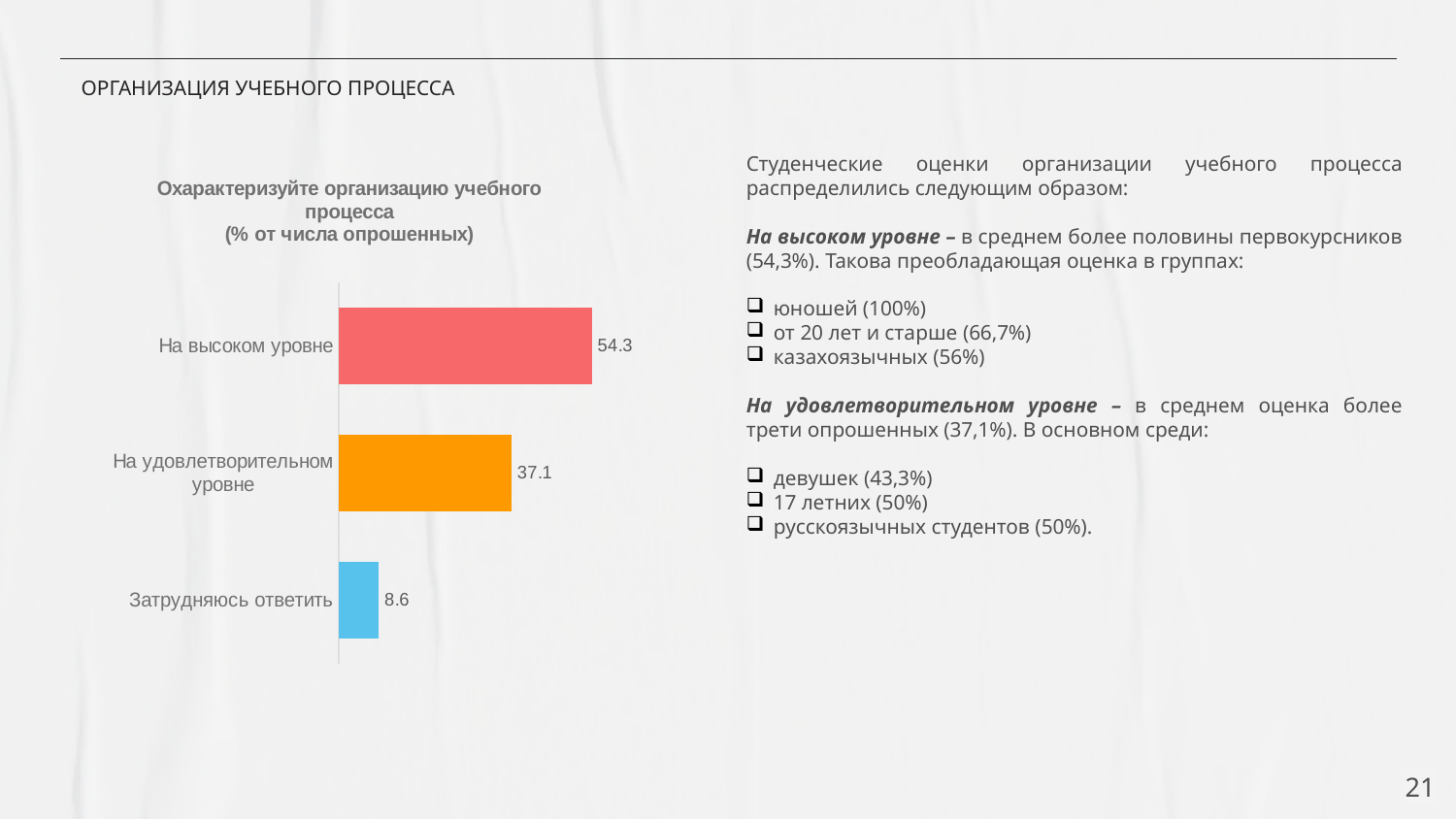
What is the difference between the values for 'На высоком уровне' and 'На удовлетворительном уровне'? 17.2 What is the value for 'Затрудняюсь ответить'? 8.6 How many categories are shown in the chart? 3 What is the value for 'На высоком уровне'? 54.3 What is the title of the chart? Охарактеризуйте организацию учебного процесса (% от числа опрошенных) What colour is the bar for 'На удовлетворительном уровне'? Orange What is the difference between the values for 'На удовлетворительном уровне' and 'Затрудняюсь ответить'? 28.5 What is the value for 'На удовлетворительном уровне'? 37.1 What kind of chart is shown on the slide? Bar chart Which is larger: the value for 'На удовлетворительном уровне' or 'Затрудняюсь ответить'? На удовлетворительном уровне Which category has the highest value? На высоком уровне Which category has the lowest value? Затрудняюсь ответить